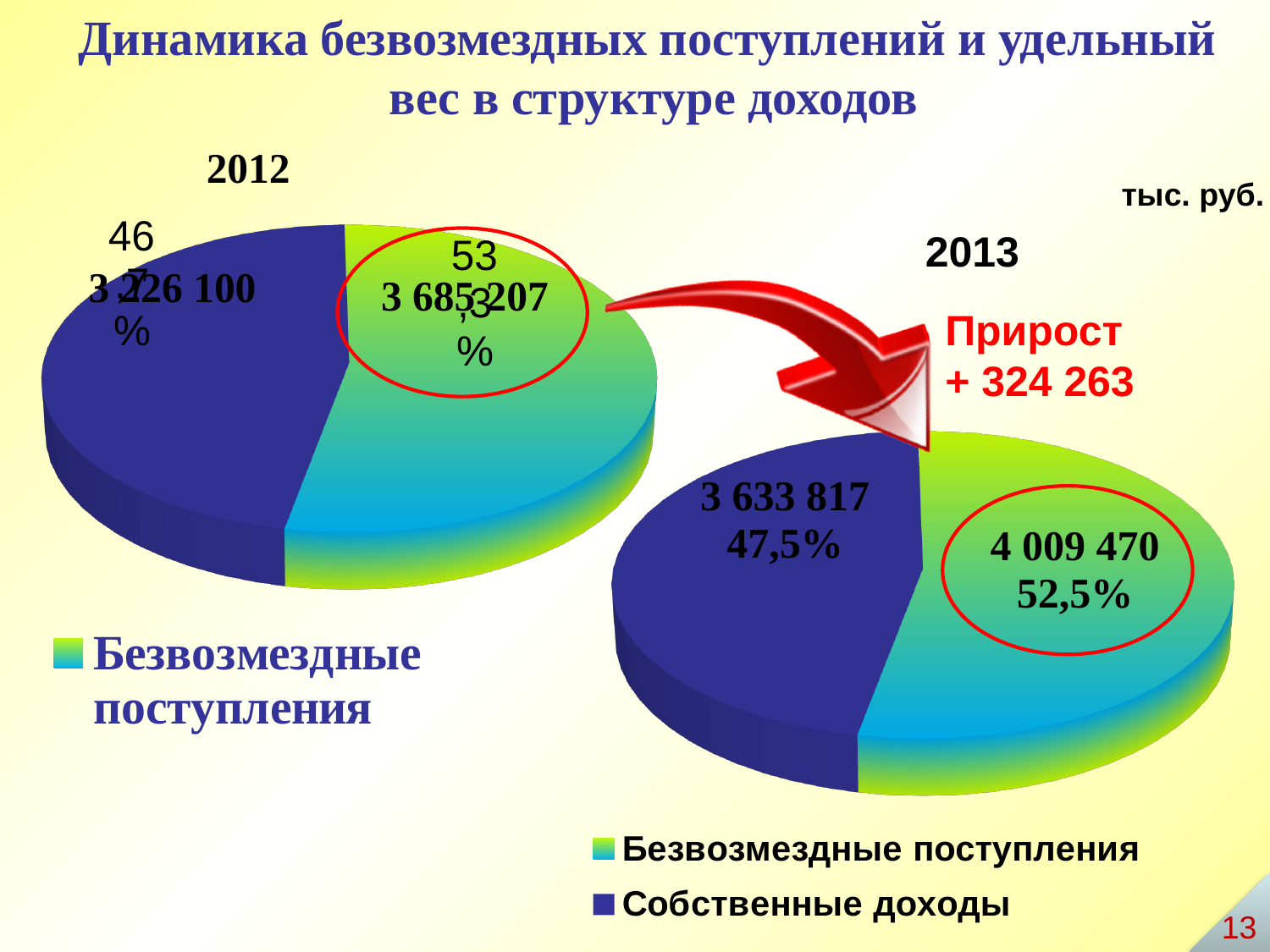
In the 2013 pie chart, what share does Безвозмездные поступления have? 52,5% In the 2013 pie chart, which category has the largest slice? Безвозмездные поступления In the 2012 pie chart, which is larger: Безвозмездные поступления or Собственные доходы? Безвозмездные поступления What growth (Прирост) in Безвозмездные поступления from 2012 to 2013 is shown on the slide? + 324 263 In the 2013 pie chart, what is the value for Безвозмездные поступления? 4 009 470 What kind of chart is used to show the 2013 data? pie chart In the 2012 pie chart, what is the value for Собственные доходы? 3 226 100 In the 2013 pie chart, what is the difference between Безвозмездные поступления and Собственные доходы? 375 653 In the 2013 pie chart, what share does Собственные доходы have? 47,5% In the 2012 pie chart, what is the value for Безвозмездные поступления? 3 685 207 How many slices does the 2013 pie chart have? 2 In the 2013 pie chart, what is the value for Собственные доходы? 3 633 817